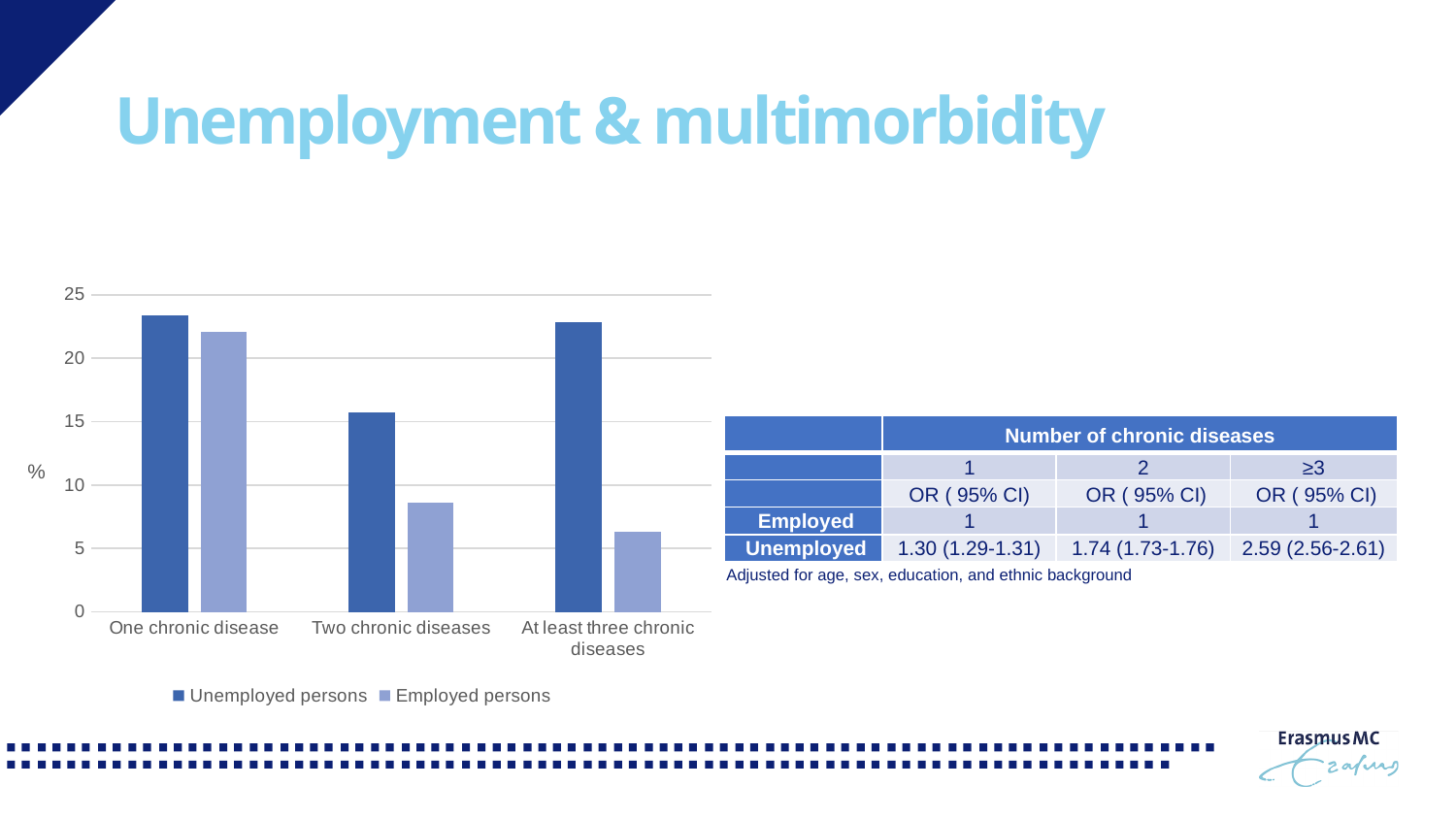
For which category is the value for Unemployed persons lowest? Two chronic diseases How many categories are shown on the x axis of the chart? 3 For which category is the value for Employed persons highest? One chronic disease Is the value for Unemployed persons with one chronic disease greater or less than 20? greater Is the value for Unemployed persons with two chronic diseases greater or less than 20? less Is the value for Employed persons with at least three chronic diseases greater or less than 10? less What is the label on the chart's vertical axis? % How many series does the chart's legend list? 2 For at least three chronic diseases, which is larger: the value for Unemployed persons or for Employed persons? Unemployed persons Which series are listed in the chart's legend? Unemployed persons and Employed persons What kind of chart is shown on the slide? bar chart